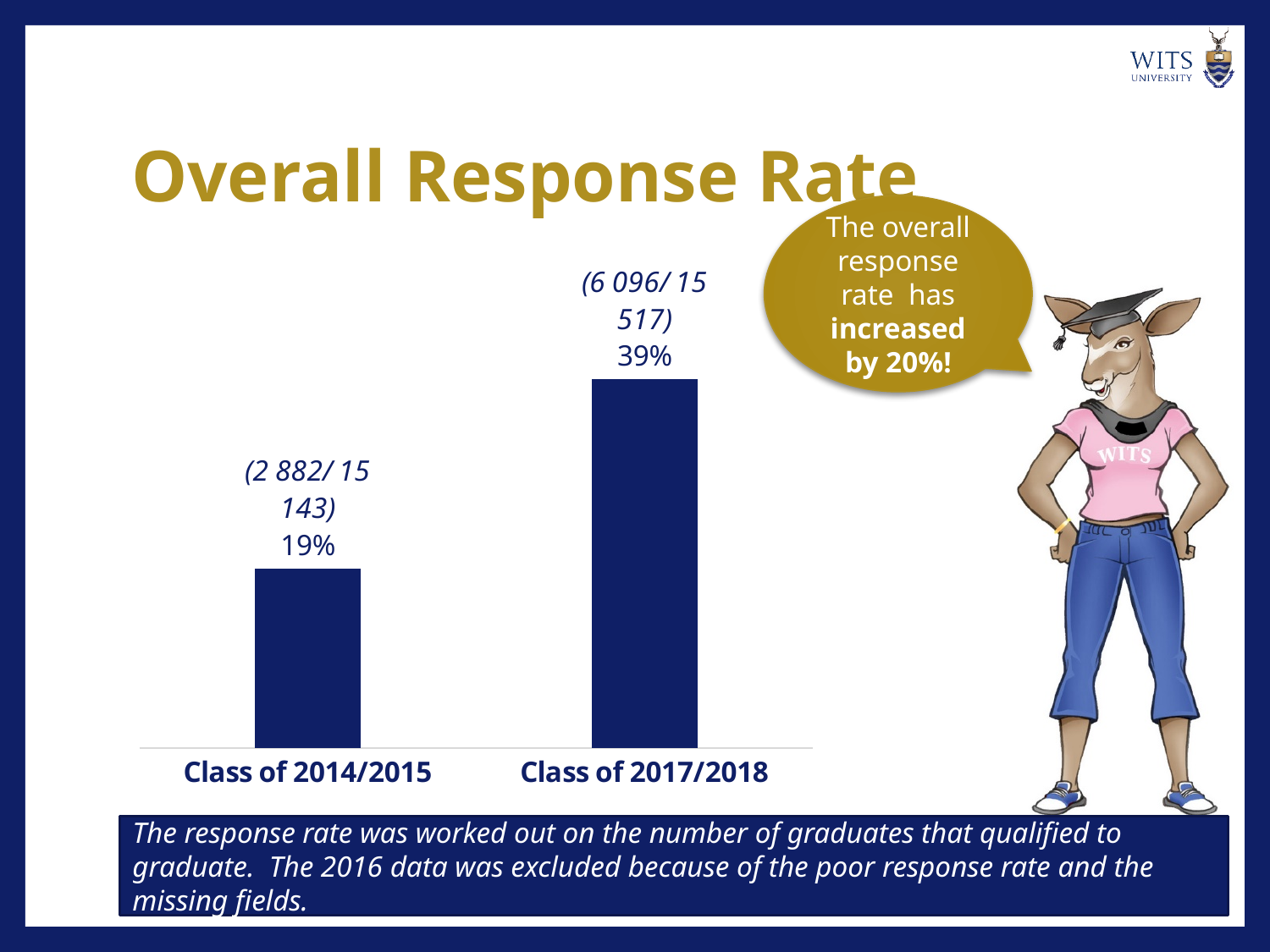
What kind of chart is shown on the slide? bar chart What is the response rate for the Class of 2017/2018? 39% What fraction is printed above the bar for the Class of 2014/2015? (2 882/ 15 143) What is the response rate for the Class of 2014/2015? 19% What is the title of the chart on the slide? Overall Response Rate Which class has the lower response rate? Class of 2014/2015 What is the difference in response rate between the Class of 2017/2018 and the Class of 2014/2015? 20% Which class has the higher response rate? Class of 2017/2018 What fraction is printed above the bar for the Class of 2017/2018? (6 096/ 15 517) Is the response rate for the Class of 2017/2018 larger or smaller than that for the Class of 2014/2015? larger How many classes are shown in the chart? 2 Does the response rate rise or fall from the Class of 2014/2015 to the Class of 2017/2018? rise